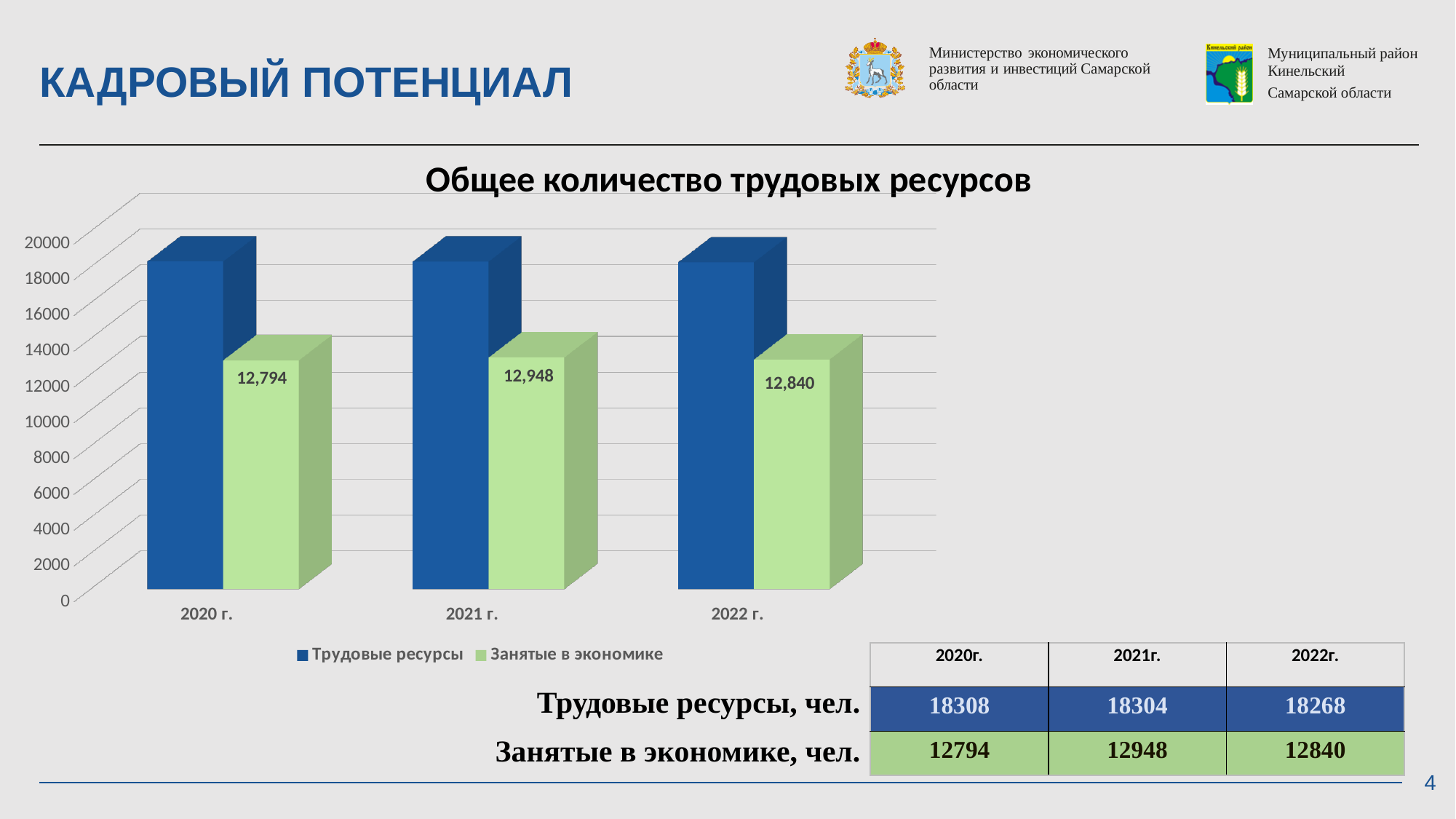
What is the difference between Занятые в экономике in 2021 г. and 2020 г.? 154 What is the title of the chart? Общее количество трудовых ресурсов In which year is Занятые в экономике the lowest? 2020 г. How many series does the chart legend list? 2 In which year is Занятые в экономике the highest? 2021 г. Which series is represented by the green bars in the chart? Занятые в экономике How many years (categories) are shown on the x axis of the chart? 3 Is the value of Трудовые ресурсы for 2020 г. greater or less than 16000? greater What is the value of Занятые в экономике for 2020 г.? 12,794 What is the value of Занятые в экономике for 2021 г.? 12,948 According to the table, what is the value of Трудовые ресурсы for 2022 г.? 18268 What type of chart is shown on the slide? bar chart